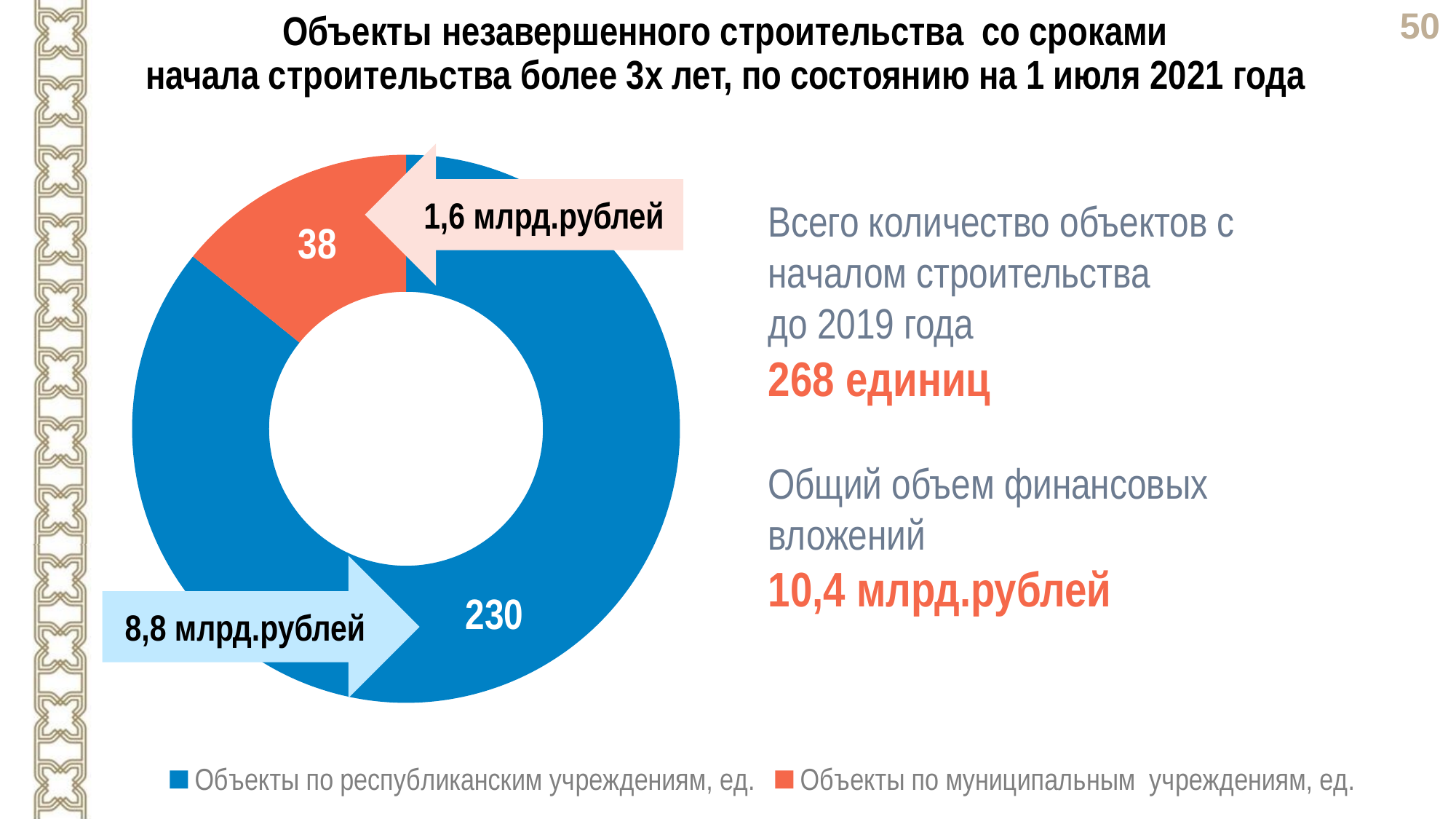
What type of chart is shown on the slide? Pie (donut) chart What is the difference between the number of republican objects and municipal objects? 192 Which category has the smaller slice in the chart? Объекты по муниципальным учреждениям, ед. What is the total number of objects across both slices of the chart? 268 How many entries does the legend list? 2 Which colour represents municipal institutions in the chart? Orange How many objects are shown for municipal institutions (Объекты по муниципальным учреждениям)? 38 How many slices does the donut chart have? 2 Which category has the larger slice in the chart? Объекты по республиканским учреждениям, ед. What financial volume is shown by the arrow pointing to the orange (municipal) slice? 1,6 млрд.рублей How many objects are shown for republican institutions (Объекты по республиканским учреждениям)? 230 What financial volume is shown by the arrow pointing to the blue (republican) slice? 8,8 млрд.рублей